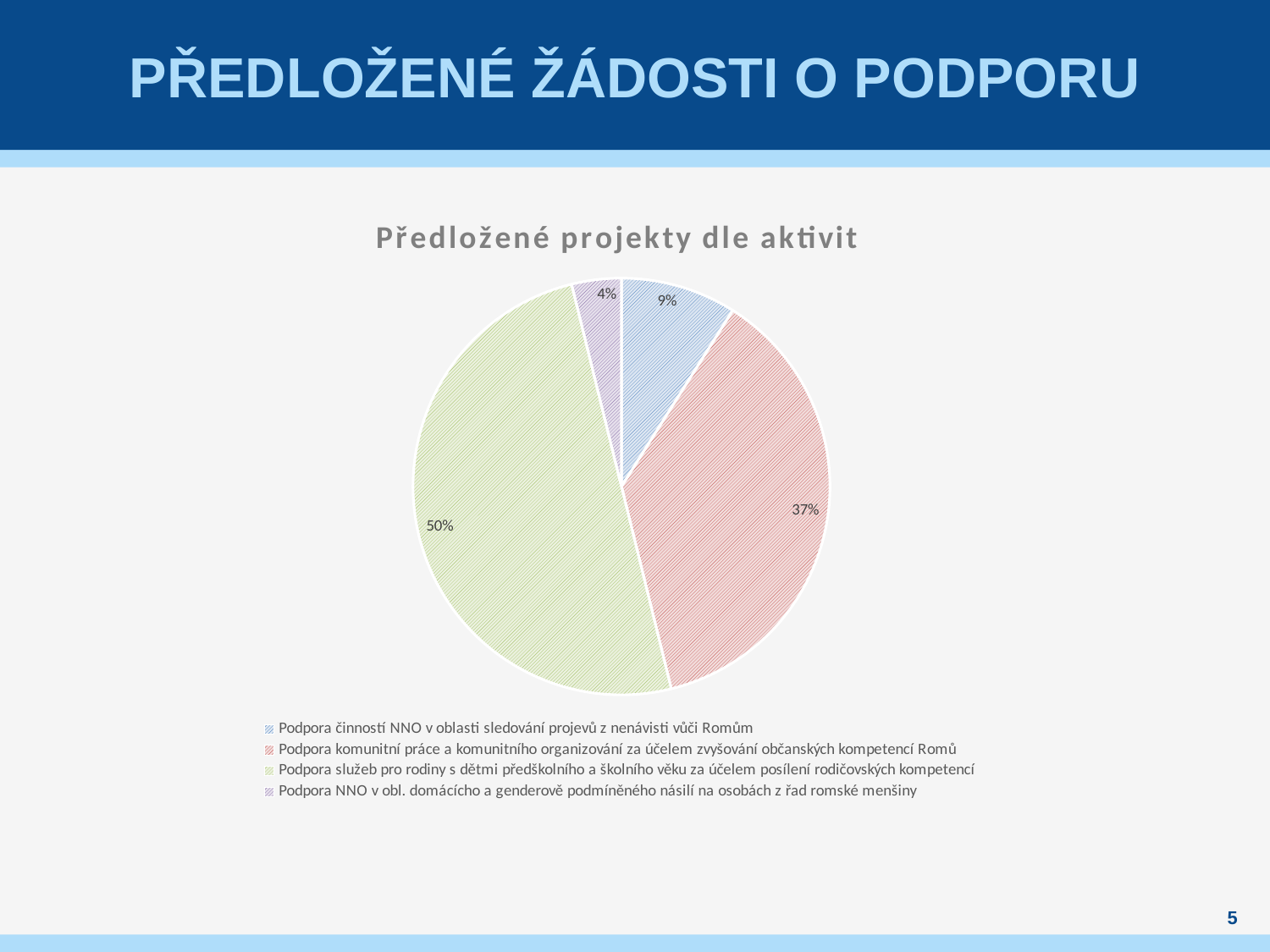
What share of the pie is 'Podpora komunitní práce a komunitního organizování za účelem zvyšování občanských kompetencí Romů'? 37% Which category has the smallest share of the pie? Podpora NNO v obl. domácícho a genderově podmíněného násilí na osobách z řad romské menšiny What share of the pie is 'Podpora služeb pro rodiny s dětmi předškolního a školního věku za účelem posílení rodičovských kompetencí'? 50% What is the title of the chart? Předložené projekty dle aktivit What share of the pie is 'Podpora NNO v obl. domácícho a genderově podmíněného násilí na osobách z řad romské menšiny'? 4% What is the difference in percentage points between the 50% slice and the 37% slice? 13 percentage points Which category has the largest share of the pie? Podpora služeb pro rodiny s dětmi předškolního a školního věku za účelem posílení rodičovských kompetencí Which is larger: the share for 'Podpora činností NNO v oblasti sledování projevů z nenávisti vůči Romům' or the share for 'Podpora NNO v obl. domácícho a genderově podmíněného násilí na osobách z řad romské menšiny'? Podpora činností NNO v oblasti sledování projevů z nenávisti vůči Romům What kind of chart is shown on the slide? Pie chart How many slices does the pie chart have? 4 How many entries does the legend list? 4